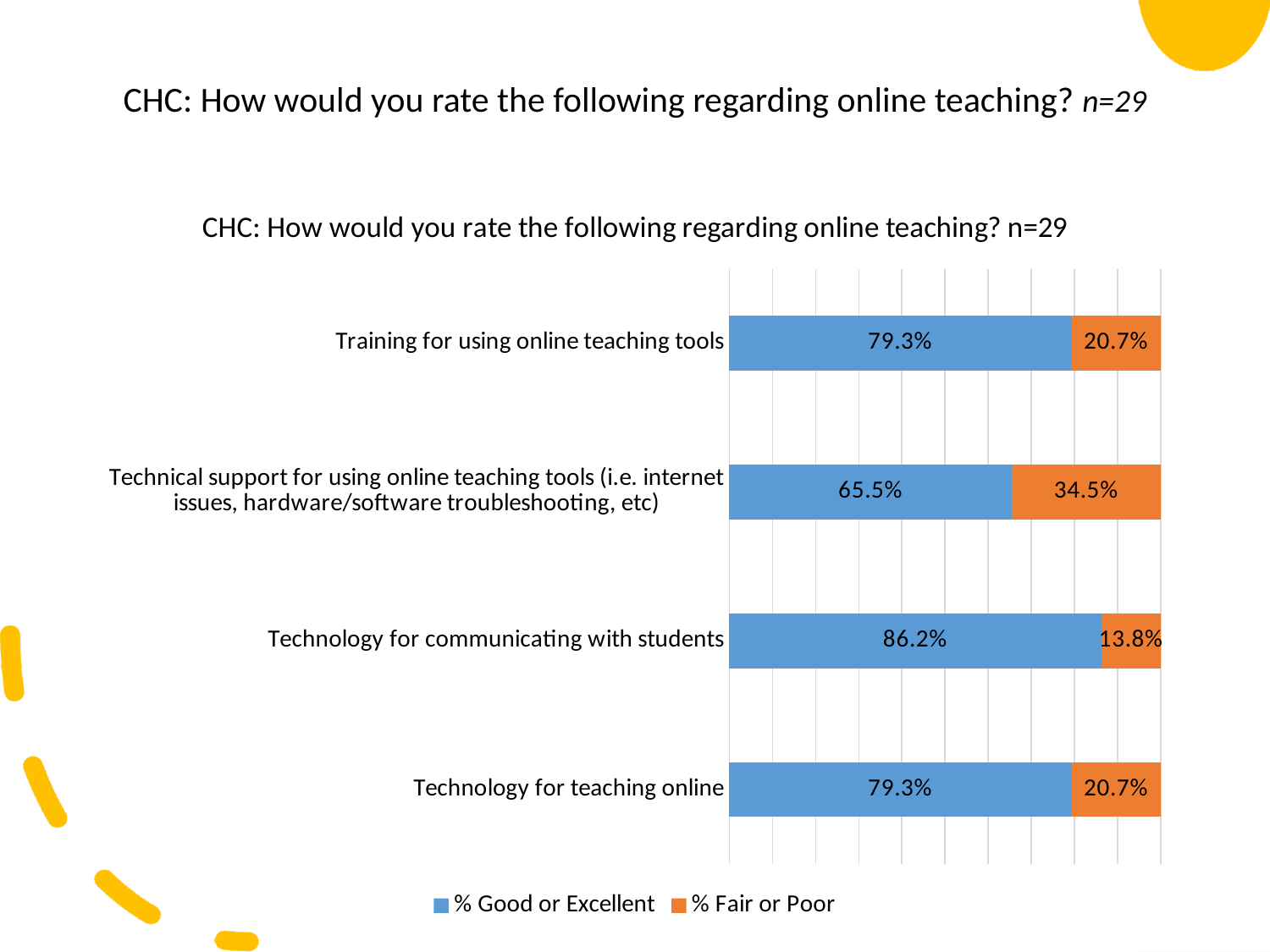
How many categories are shown in the chart? 4 What kind of chart is shown on the slide? Stacked bar chart What is the % Fair or Poor value for Technical support for using online teaching tools (i.e. internet issues, hardware/software troubleshooting, etc)? 34.5% What is the difference between the % Good or Excellent values for Technology for communicating with students and Technical support for using online teaching tools? 20.7% What is the % Good or Excellent value for Technology for communicating with students? 86.2% What is the % Fair or Poor value for Technology for teaching online? 20.7% Which category has the lowest % Good or Excellent value? Technical support for using online teaching tools (i.e. internet issues, hardware/software troubleshooting, etc) What is the % Good or Excellent value for Training for using online teaching tools? 79.3% Which category has the highest % Fair or Poor value? Technical support for using online teaching tools (i.e. internet issues, hardware/software troubleshooting, etc) How many series does the legend list? 2 Which category has the highest % Good or Excellent value? Technology for communicating with students Which is larger: the % Fair or Poor value for Technology for communicating with students or for Training for using online teaching tools? Training for using online teaching tools